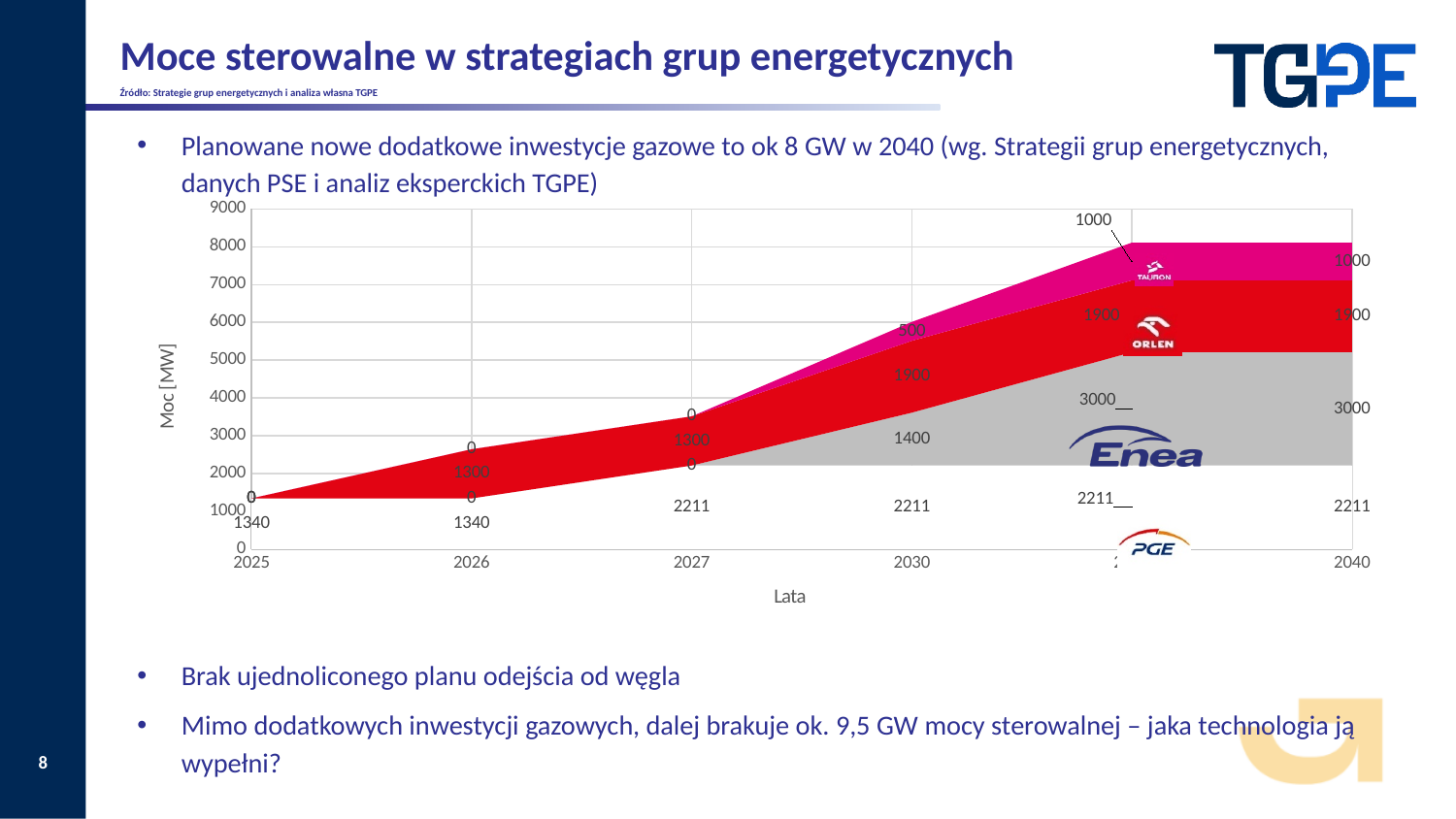
Does the total stacked value rise or fall from 2025 to 2040? rise What is the value of the magenta (Tauron) series in 2030? 500 What is the title of the x axis of the chart? Lata What is the title of the y axis of the chart? Moc [MW] What kind of chart is shown on the slide? stacked area chart What is the value of the grey (Enea) series in 2030? 1400 What is the value of the grey (Enea) series in 2040? 3000 What is the value of the bottom (PGE) series in 2025? 1340 What is the value of the bottom (PGE) series in 2040? 2211 What is the value of the red (Orlen) series in 2040? 1900 What is the total stacked value across all series in 2040? 8111 By how much does the grey (Enea) series value in 2040 exceed its value in 2030? 1600